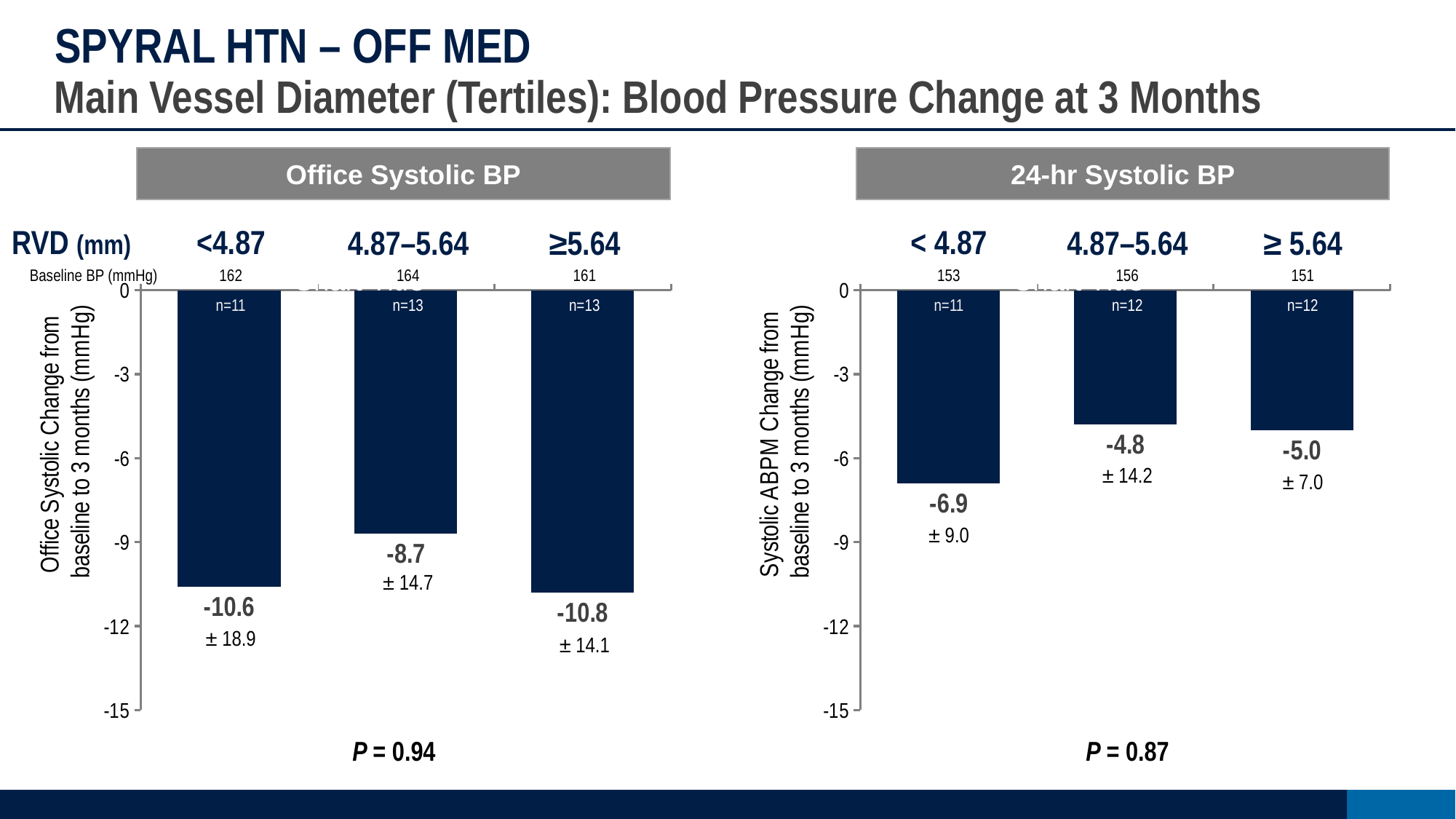
In the Office Systolic BP chart, what is the difference between the changes for the ≥5.64 and 4.87–5.64 tertiles? 2.1 In the 24-hr Systolic BP chart, what is the difference between the changes for the <4.87 and 4.87–5.64 tertiles? 2.1 In the 24-hr Systolic BP chart, is the reduction for the <4.87 tertile larger or smaller than the reduction for the ≥5.64 tertile? larger In the 24-hr Systolic BP chart, what is the change from baseline for the <4.87 mm RVD tertile? -6.9 What type of chart is used for the 24-hr Systolic BP panel? bar chart In the 24-hr Systolic BP chart, what is the change from baseline for the ≥5.64 mm RVD tertile? -5.0 In the 24-hr Systolic BP chart, which RVD tertile shows the largest reduction in systolic BP? <4.87 In the Office Systolic BP chart, what is the change from baseline for the <4.87 mm RVD tertile? -10.6 In the Office Systolic BP chart, which RVD tertile shows the smallest reduction in systolic BP? 4.87–5.64 In the Office Systolic BP chart, what is the change from baseline for the 4.87–5.64 mm RVD tertile? -8.7 How many RVD tertiles are plotted in the Office Systolic BP chart? 3 What P value is shown below the Office Systolic BP chart? P = 0.94